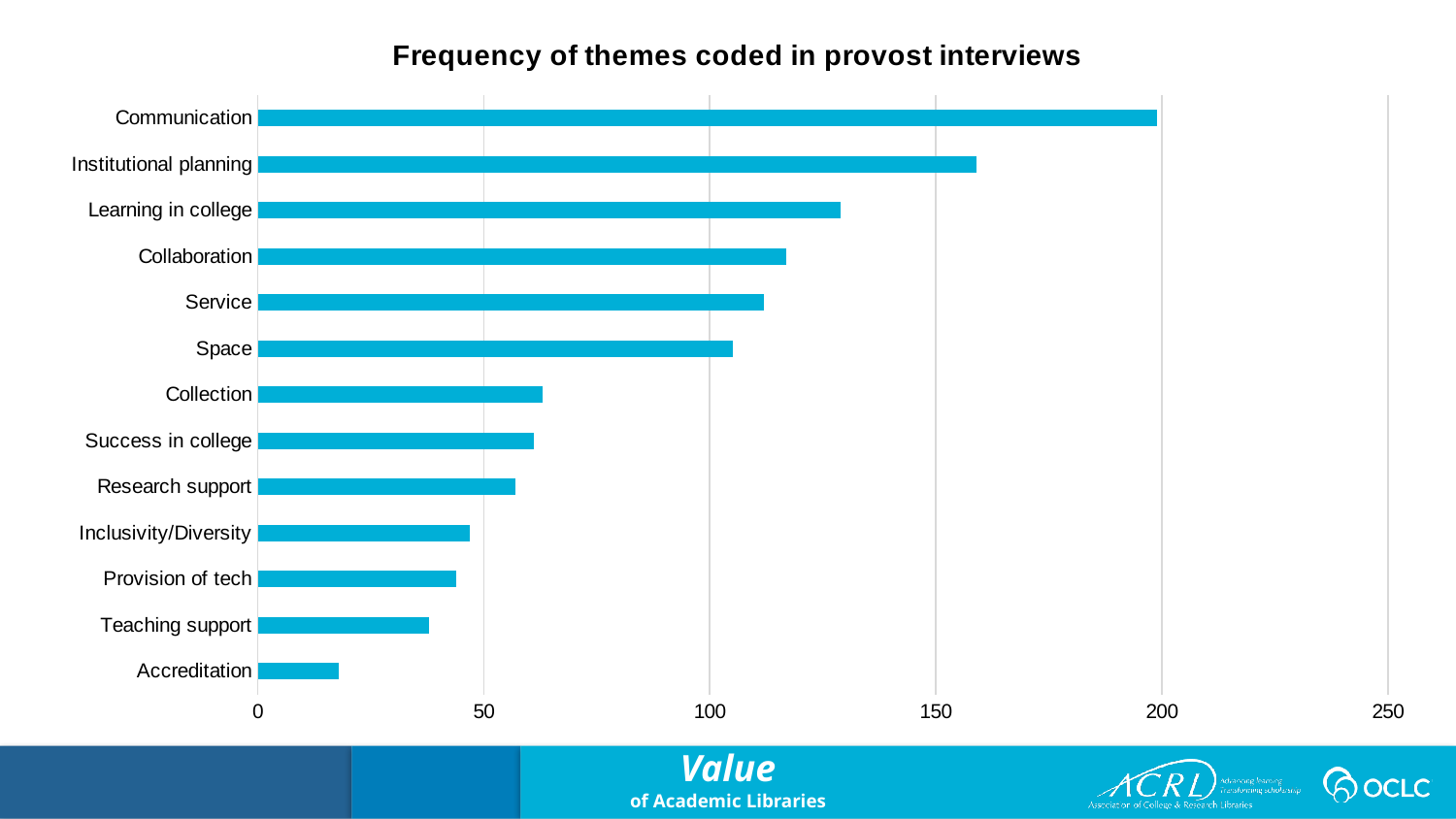
Is the value for Learning in college greater or less than 150? less Which theme has the highest frequency? Communication Is the value for Teaching support greater or less than 50? less How many themes (categories) are plotted in the chart? 13 Is the value for Institutional planning greater or less than 150? greater Which has a higher frequency, Space or Collection? Space What type of chart is shown on the slide? bar chart Which theme has the lowest frequency? Accreditation What is the title of the chart? Frequency of themes coded in provost interviews Which has a higher frequency, Communication or Institutional planning? Communication